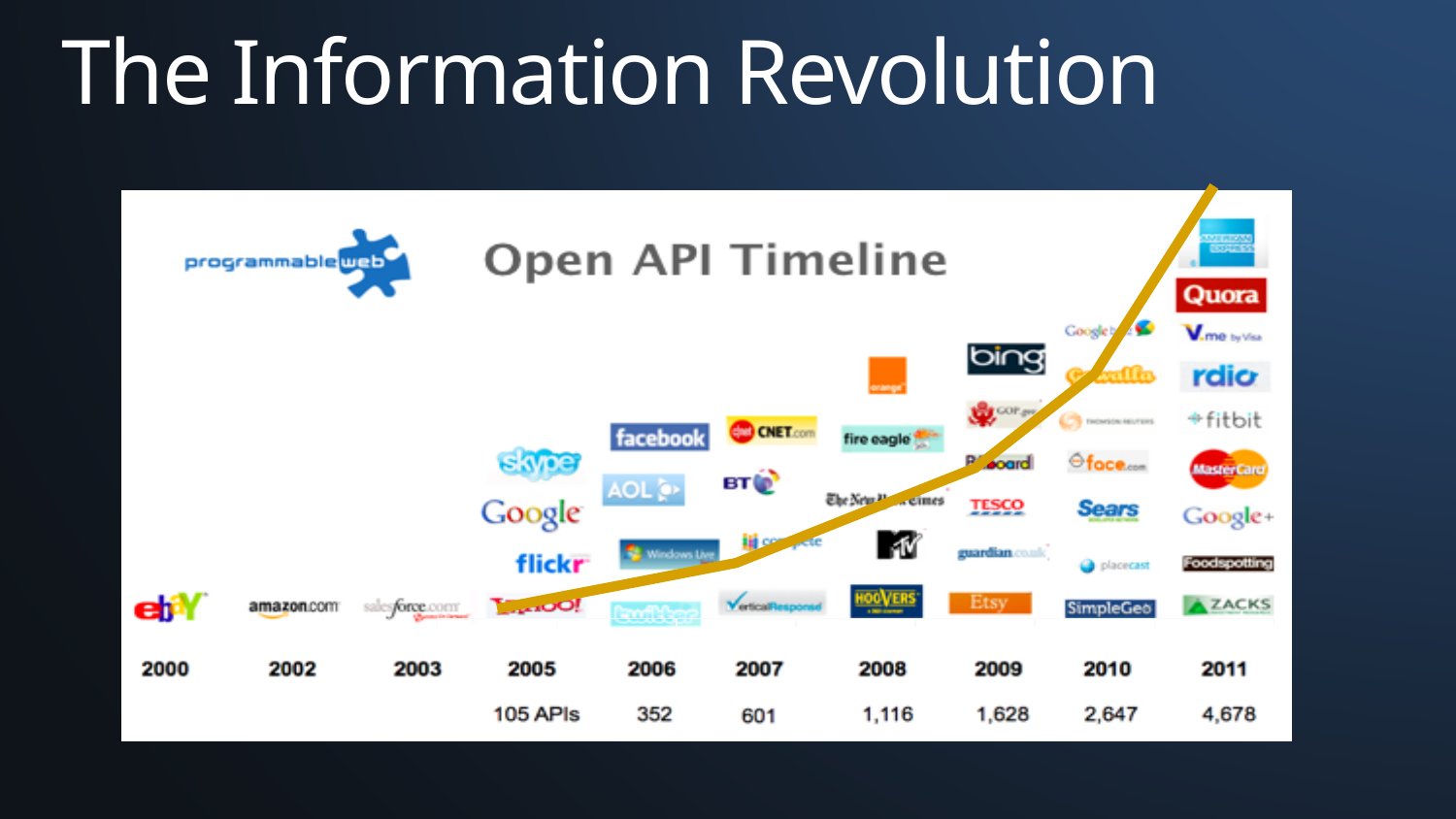
Do the API counts on the Open API Timeline rise or fall from 2005 to 2011? rise What is the number of APIs shown for 2011 on the Open API Timeline? 4,678 Which year on the Open API Timeline has the highest number of APIs? 2011 Which is larger on the Open API Timeline: the API count for 2009 or for 2010? 2010 What is the difference between the API counts for 2007 and 2006 on the Open API Timeline? 249 How many years are labelled along the bottom of the Open API Timeline? 10 What is the number of APIs shown for 2008 on the Open API Timeline? 1,116 What is the number of APIs shown for 2009 on the Open API Timeline? 1,628 Among the years with an API count printed, which year has the lowest number of APIs? 2005 What is the title of the timeline graphic shown on the slide? Open API Timeline How many APIs are listed for 2005 on the Open API Timeline? 105 APIs What is the difference between the API counts for 2011 and 2010 on the Open API Timeline? 2,031